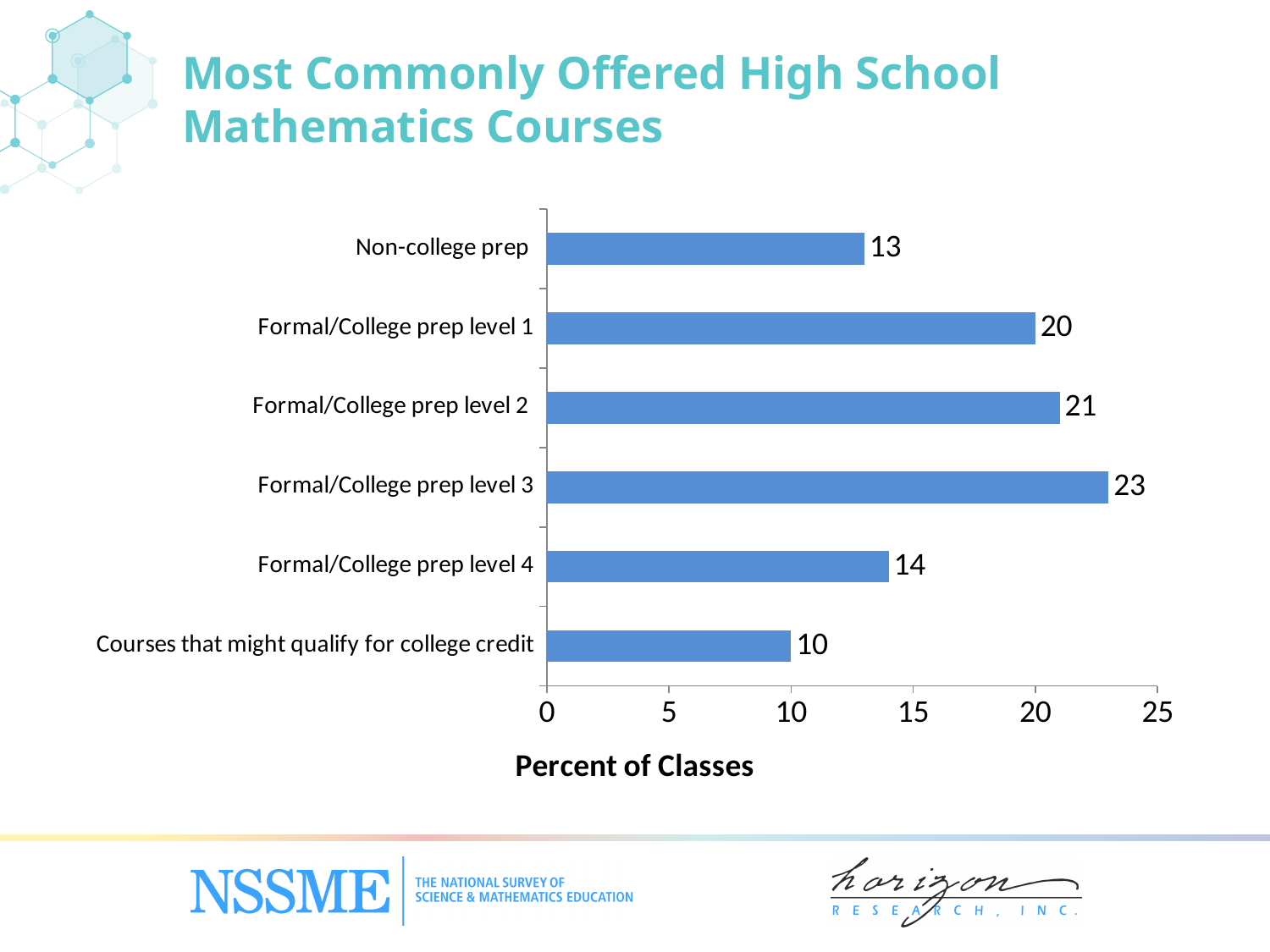
What is the value for Formal/College prep level 4? 14 Which is larger, the value for Formal/College prep level 1 or the value for Non-college prep? Formal/College prep level 1 Is the value for Formal/College prep level 2 greater or less than 15? greater What is the label of the horizontal axis? Percent of Classes Which category has the lowest value? Courses that might qualify for college credit What is the value for Non-college prep? 13 What kind of chart is shown on the slide? bar chart What is the difference between the values for Formal/College prep level 3 and Formal/College prep level 4? 9 How many categories are shown in the chart? 6 What is the value for Formal/College prep level 3? 23 Which category has the highest value? Formal/College prep level 3 What is the value for Courses that might qualify for college credit? 10